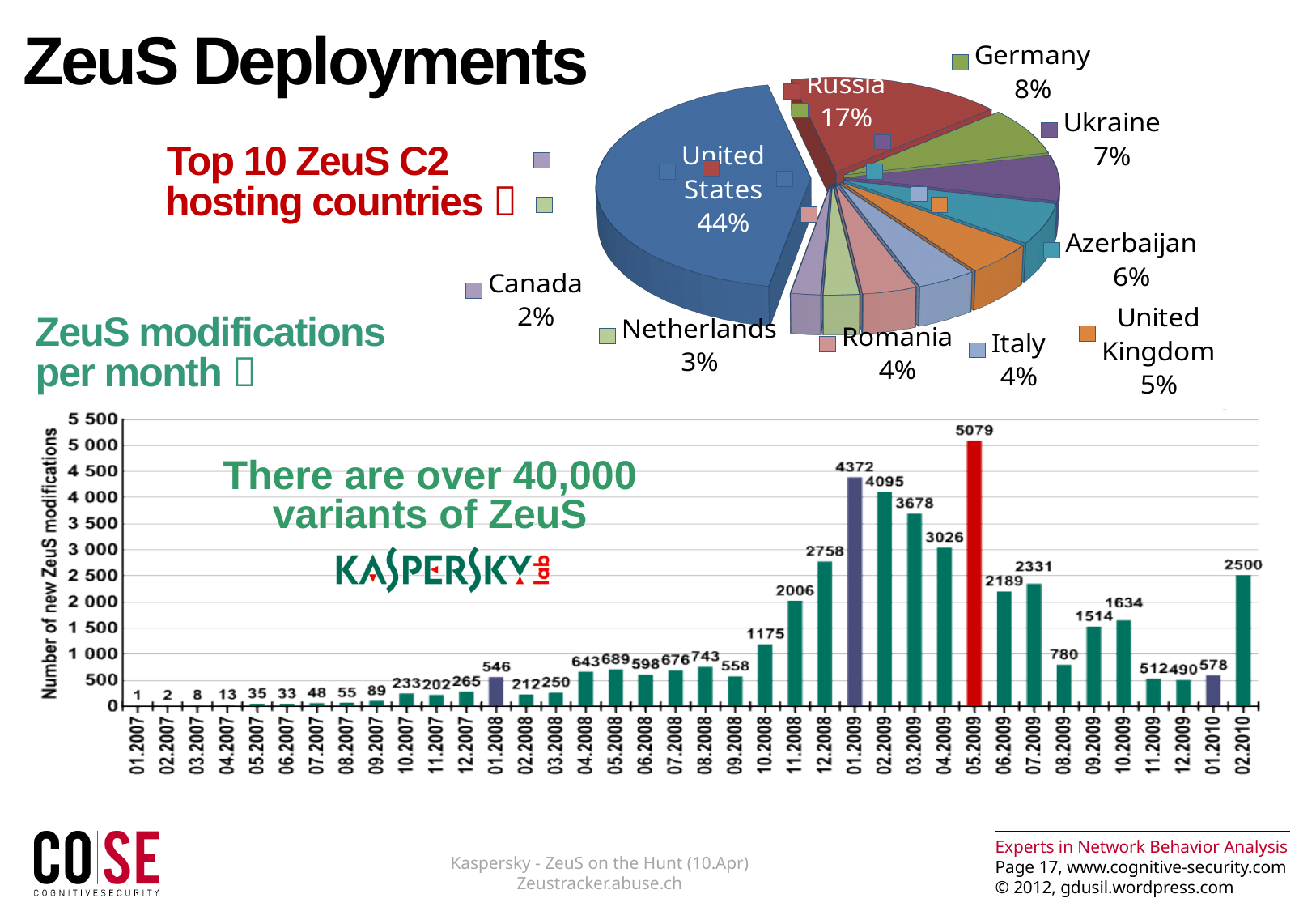
In the pie chart of top 10 ZeuS C2 hosting countries, which is larger, Germany's share or Ukraine's share? Germany What kind of chart is the ZeuS modifications per month chart? Bar chart In the pie chart of top 10 ZeuS C2 hosting countries, what is the difference between the shares of the United States and Russia? 27% In the pie chart of top 10 ZeuS C2 hosting countries, how many countries are shown? 10 In the ZeuS modifications per month bar chart, what is the difference between the values for 01.2009 and 02.2009? 277 In the pie chart of top 10 ZeuS C2 hosting countries, which country has the smallest share? Canada In the pie chart of top 10 ZeuS C2 hosting countries, what share does the United States have? 44% In the ZeuS modifications per month bar chart, which month has the highest value? 05.2009 In the ZeuS modifications per month bar chart, what is the value for 05.2009? 5079 In the pie chart of top 10 ZeuS C2 hosting countries, what share does Russia have? 17% In the ZeuS modifications per month bar chart, what is the value for 02.2010? 2500 In the ZeuS modifications per month bar chart, which is larger, the value for 10.2008 or the value for 11.2008? 11.2008